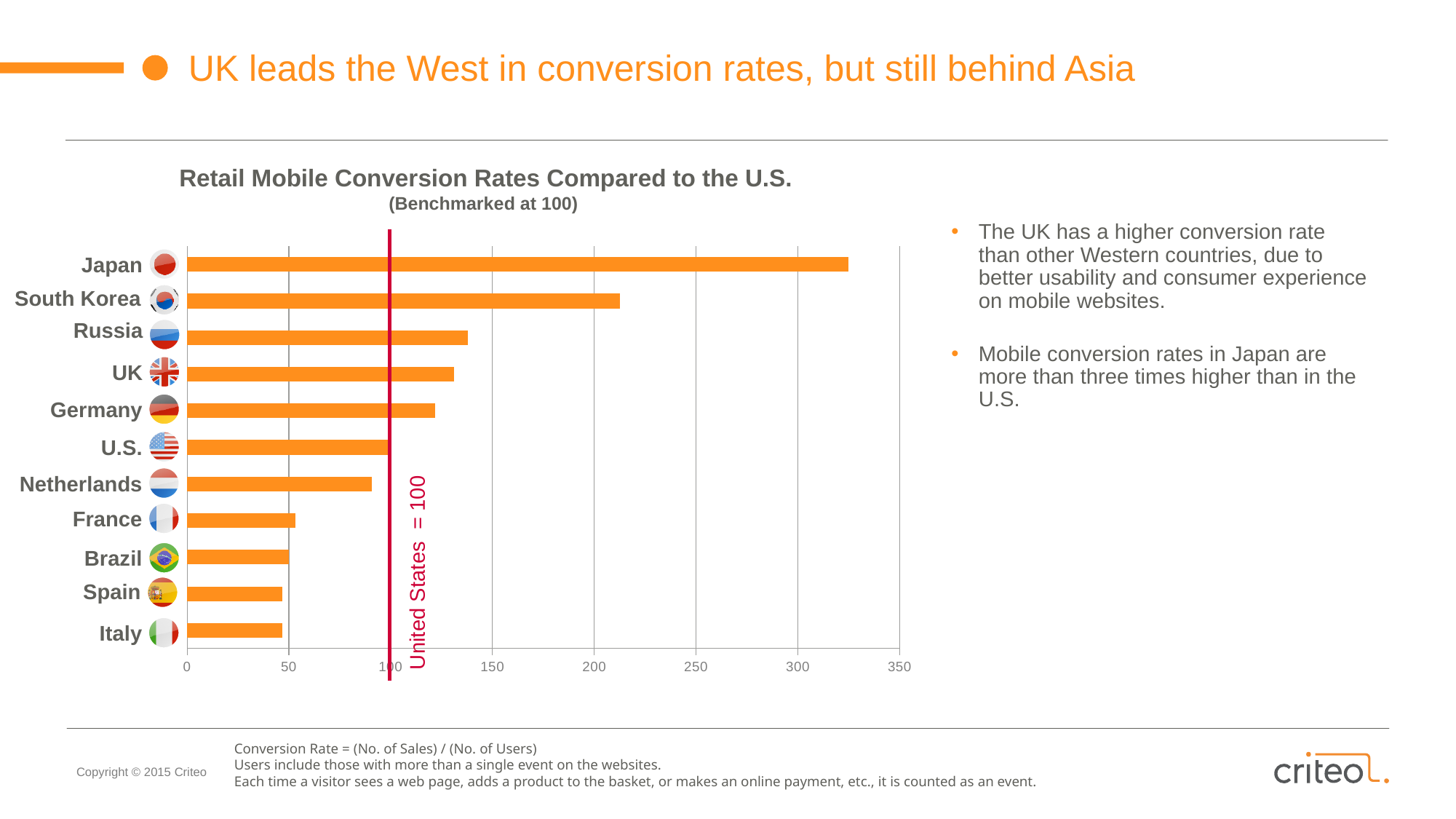
How many countries are plotted in the chart? 11 Which country has the highest retail mobile conversion rate in the chart? Japan Is the value for South Korea greater or less than 200? greater What kind of chart is shown on the slide? bar chart What is the benchmark value for the U.S. in the chart? 100 What is the title of the chart? Retail Mobile Conversion Rates Compared to the U.S. Which has a higher conversion rate, the Netherlands or France? Netherlands Is the value for Russia greater or less than 100? greater Is the value for the Netherlands greater or less than 100? less Which has a higher conversion rate, Japan or South Korea? Japan